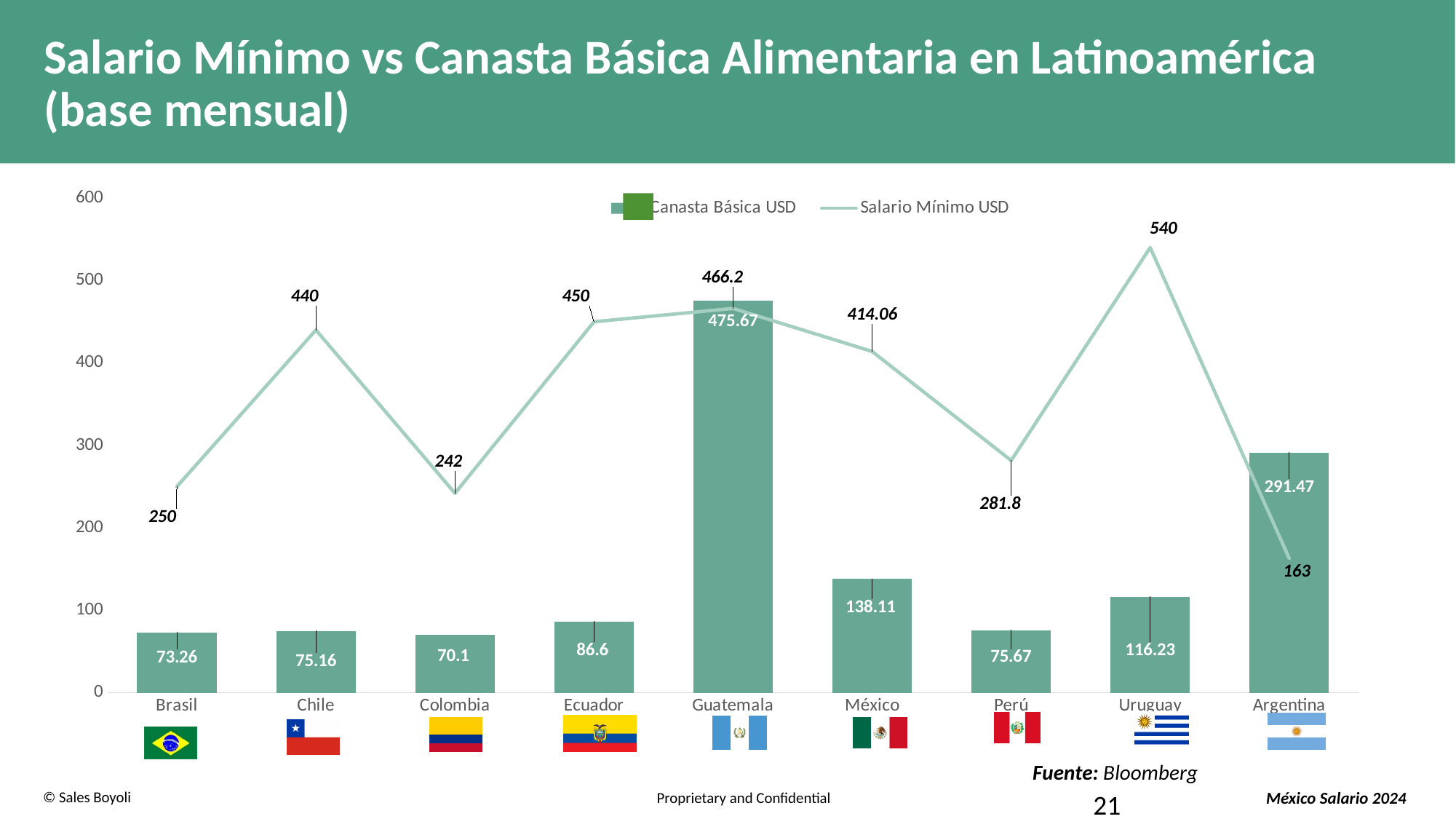
Which country has the highest Salario Mínimo USD? Uruguay Which is larger for Guatemala, the Canasta Básica USD or the Salario Mínimo USD? Canasta Básica USD What is the difference between the Salario Mínimo USD and the Canasta Básica USD for Argentina? 128.47 What kind of chart is shown on the slide? Combined bar and line chart What is the Canasta Básica USD value for Guatemala? 475.67 Which country has the lowest Salario Mínimo USD? Argentina What is the Salario Mínimo USD value for Uruguay? 540 How many countries are shown on the x axis? 9 How many series does the legend list? 2 What is the Canasta Básica USD value for México? 138.11 Which country has the lowest Canasta Básica USD? Colombia What is the Salario Mínimo USD value for Colombia? 242